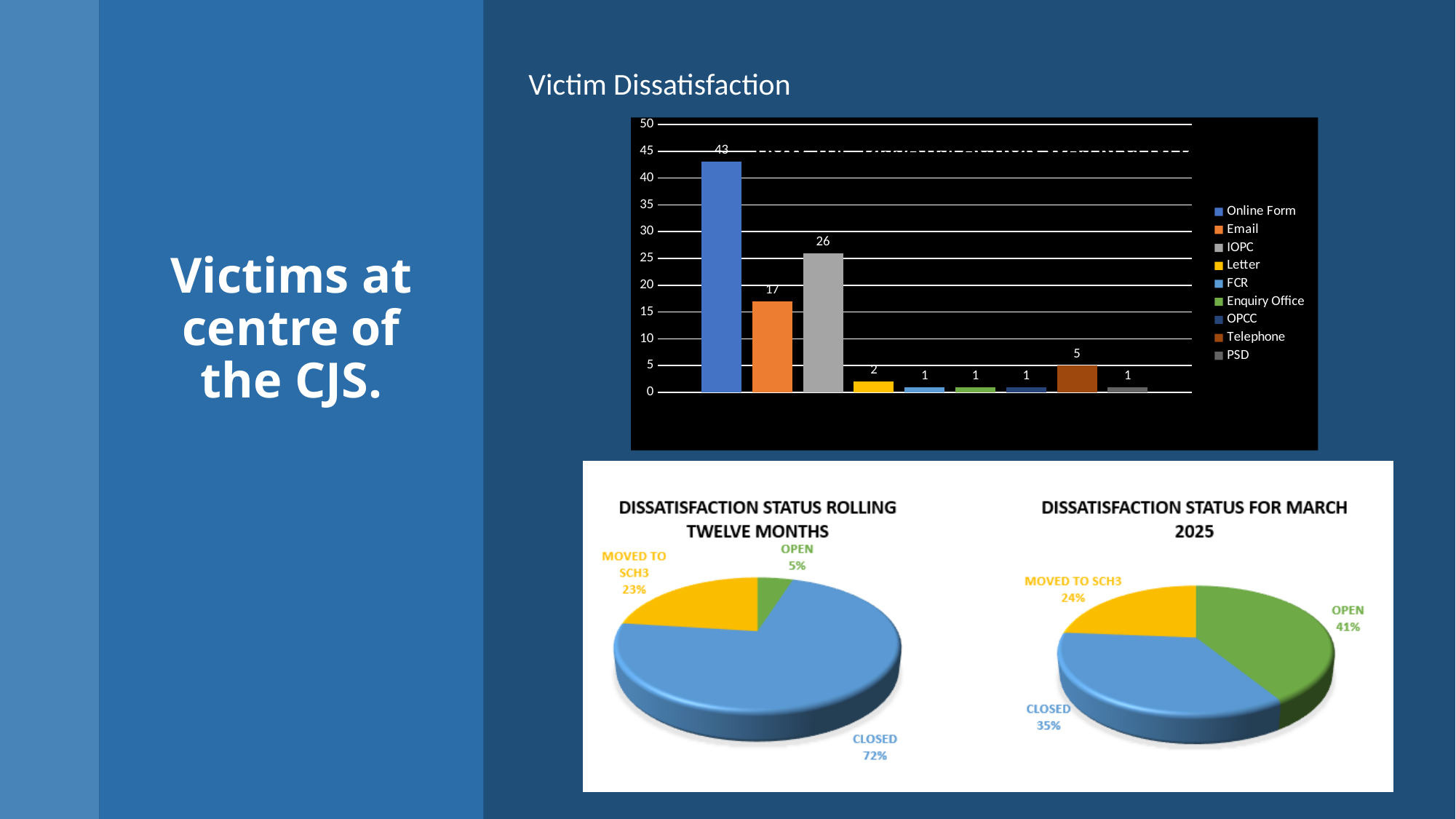
In the Victim Dissatisfaction bar chart at the top, which is larger, the value for Email or the value for IOPC? IOPC In the Victim Dissatisfaction bar chart at the top, which category has the highest value? Online Form What kind of chart is the Victim Dissatisfaction chart at the top of the slide? Bar chart In the Victim Dissatisfaction bar chart at the top, what is the value for IOPC? 26 In the Victim Dissatisfaction bar chart at the top, what is the value for Online Form? 43 How many entries does the legend of the Victim Dissatisfaction bar chart at the top list? 9 In the Dissatisfaction Status for March 2025 pie chart, which slice is the largest? Open In the Victim Dissatisfaction bar chart at the top, what is the value for Telephone? 5 In the Dissatisfaction Status Rolling Twelve Months pie chart, what share is Closed? 72% In the Victim Dissatisfaction bar chart at the top, what is the difference between the Online Form and Email values? 26 In the Dissatisfaction Status Rolling Twelve Months pie chart, what share is Open? 5% In the Dissatisfaction Status for March 2025 pie chart, what share is Moved to SCH3? 24%